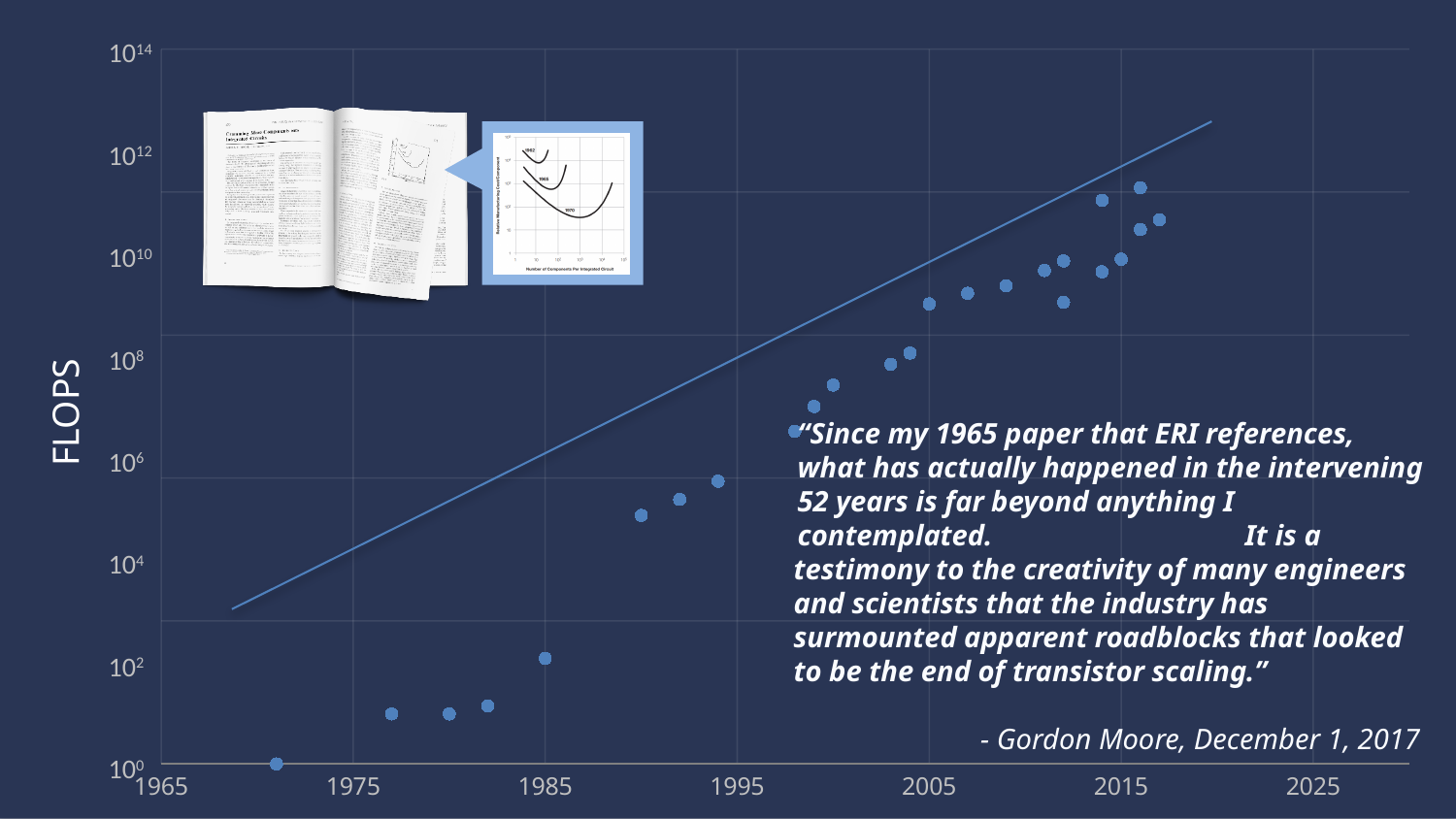
What is the highest value shown on the y axis of the chart? 10^14 Which has the larger plotted value, the point at 1985 or the point at 2005? 2005 Is the value plotted at 1985 greater or less than 10^0 FLOPS? greater What is the label on the y axis of the chart? FLOPS Do the plotted values generally rise or fall as the years increase along the x axis? rise Is the value plotted at 2005 greater or less than 10^8 FLOPS? greater Is the value plotted at 1990 greater or less than 10^6 FLOPS? less Which has the larger plotted value, the point at 1990 or the point at 2005? 2005 What kind of chart is shown on the slide? scatter chart